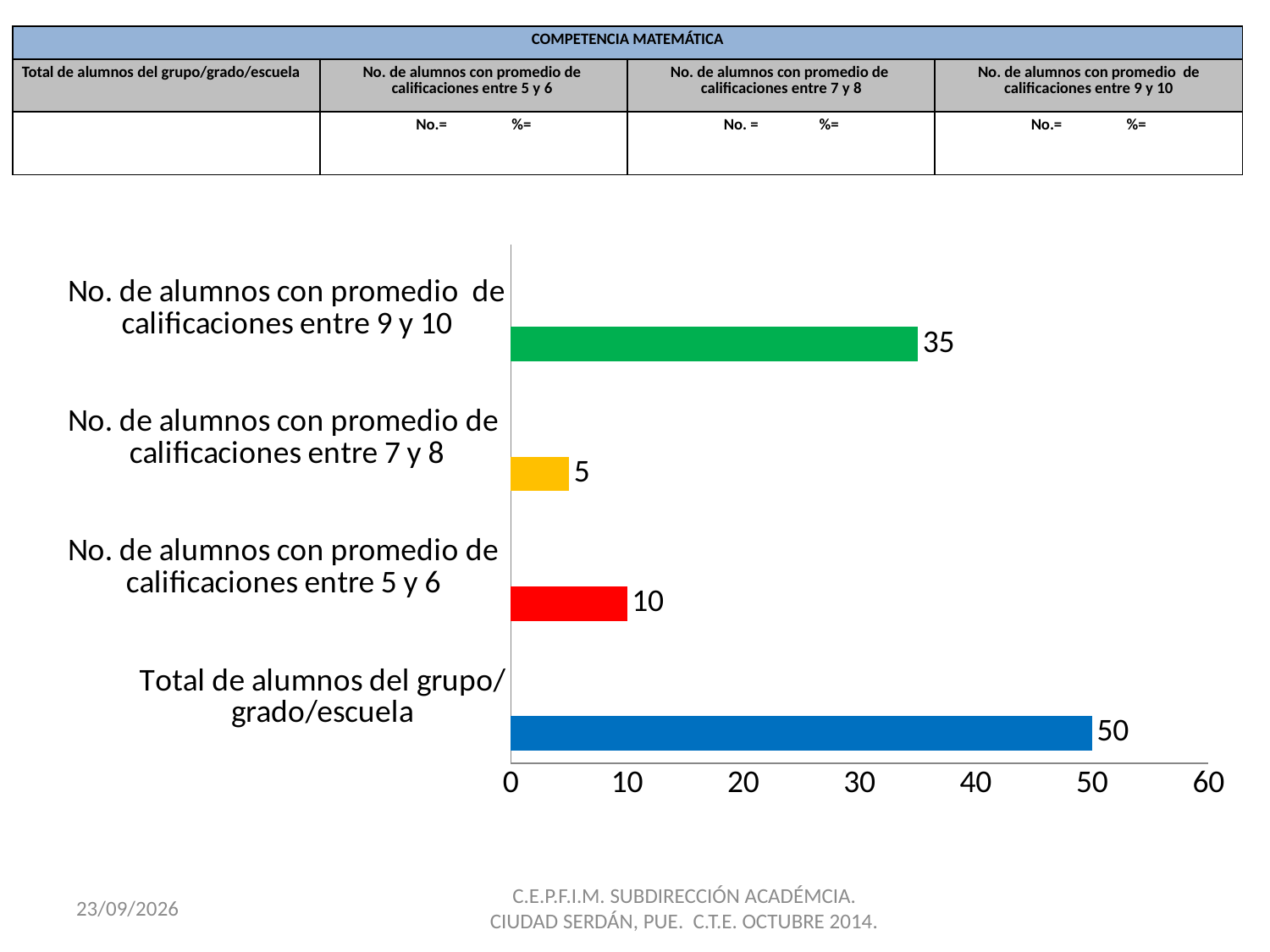
What is the difference between the value for 'No. de alumnos con promedio de calificaciones entre 9 y 10' and the value for 'No. de alumnos con promedio de calificaciones entre 5 y 6'? 25 Which category has the lowest value? No. de alumnos con promedio de calificaciones entre 7 y 8 What is the value for 'No. de alumnos con promedio de calificaciones entre 7 y 8'? 5 Is the value for 'No. de alumnos con promedio de calificaciones entre 9 y 10' greater or less than 30? greater What colour is the bar for 'No. de alumnos con promedio de calificaciones entre 5 y 6'? red Which is larger: the value for 'No. de alumnos con promedio de calificaciones entre 5 y 6' or the value for 'No. de alumnos con promedio de calificaciones entre 7 y 8'? No. de alumnos con promedio de calificaciones entre 5 y 6 How many categories are shown in the bar chart? 4 What is the value for 'Total de alumnos del grupo/grado/escuela'? 50 Which category has the highest value? Total de alumnos del grupo/grado/escuela What is the value for 'No. de alumnos con promedio de calificaciones entre 5 y 6'? 10 What is the value for 'No. de alumnos con promedio de calificaciones entre 9 y 10'? 35 What kind of chart is shown on the slide? bar chart